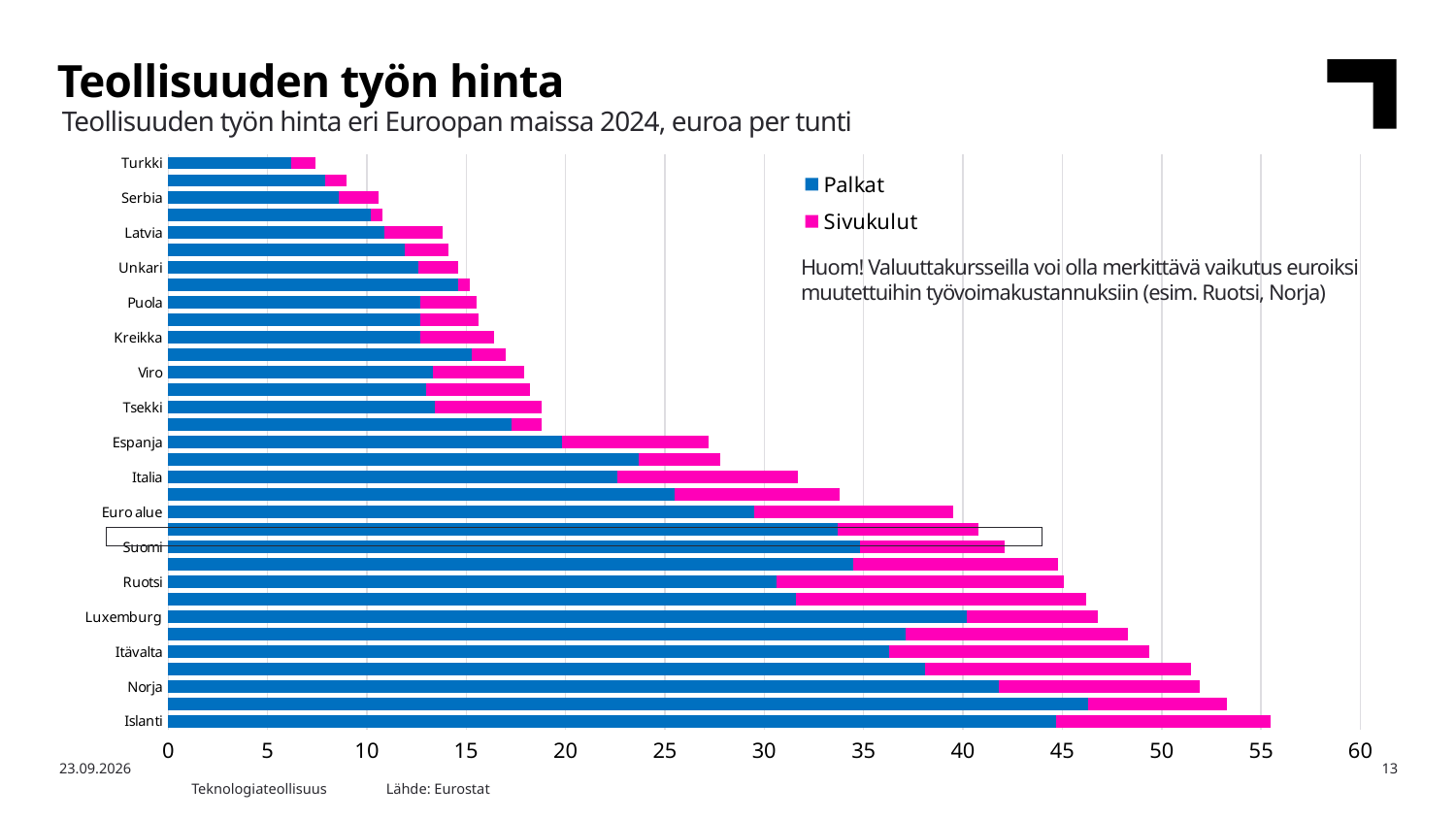
Is the total value for Islanti greater or less than 50? greater Which country has the shortest total bar? Turkki Do the total bar lengths increase or decrease going down the chart from Turkki to Islanti? increase Is the total value for Latvia greater or less than 15? less What kind of chart is shown on the slide? Stacked horizontal bar chart Which has a larger total bar, Norja or Espanja? Norja What are the two series named in the legend? Palkat and Sivukulut Which country has the longest total bar? Islanti How many series does the legend list? 2 Is the total value for Turkki greater or less than 10? less